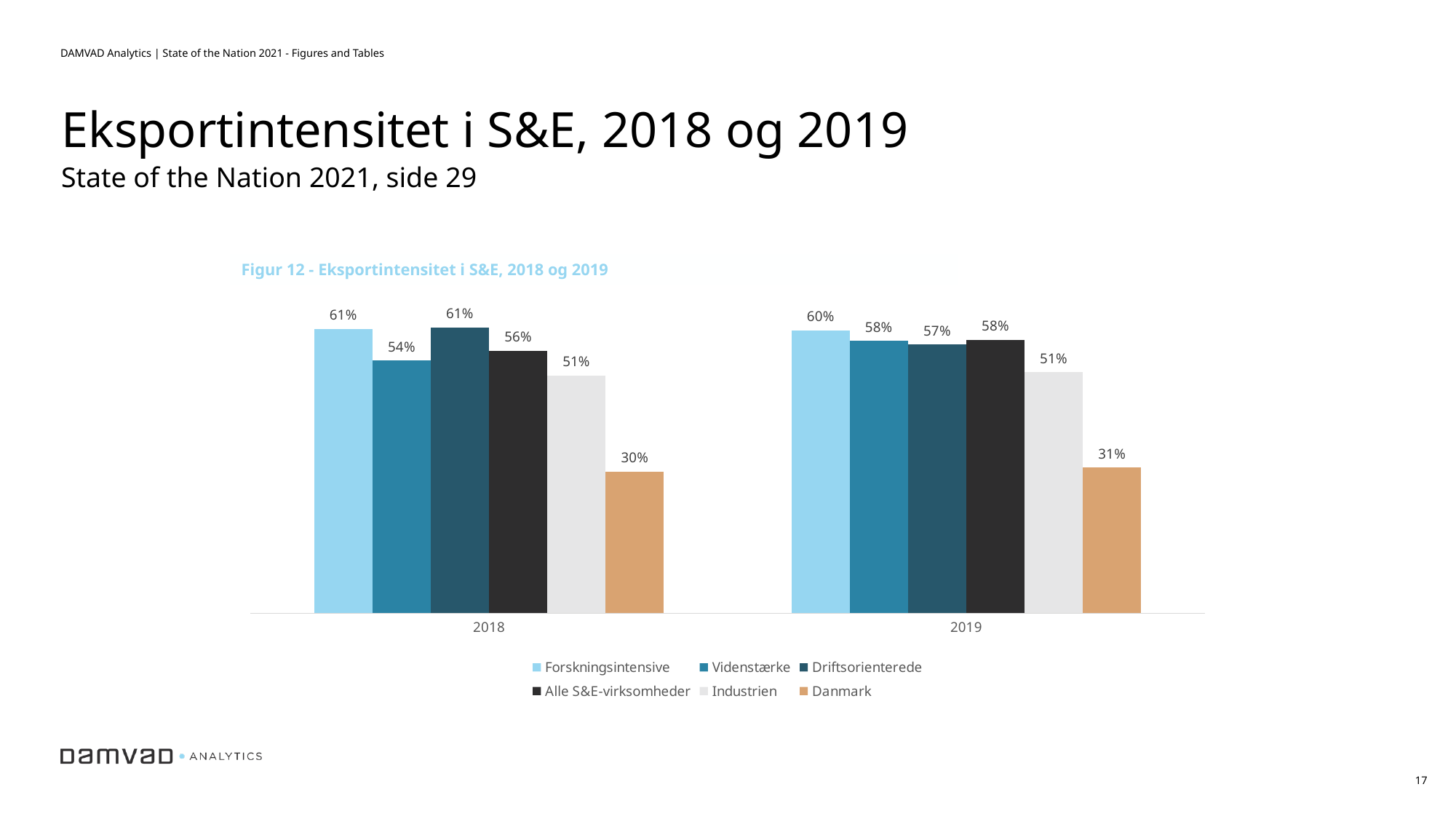
What is the value for Industrien in 2018? 51% What is the title of the figure? Figur 12 - Eksportintensitet i S&E, 2018 og 2019 What kind of chart is shown? Bar chart What is the value for Danmark in 2019? 31% How many year categories are shown on the x axis? 2 What is the value for Videnstærke in 2019? 58% What is the value for Forskningsintensive in 2018? 61% How many series does the legend list? 6 What is the difference between Videnstærke in 2019 and Videnstærke in 2018? 4% Which series has the lowest value in 2019? Danmark Which is larger: Alle S&E-virksomheder in 2018 or Alle S&E-virksomheder in 2019? 2019 Which series has the highest value in 2019? Forskningsintensive